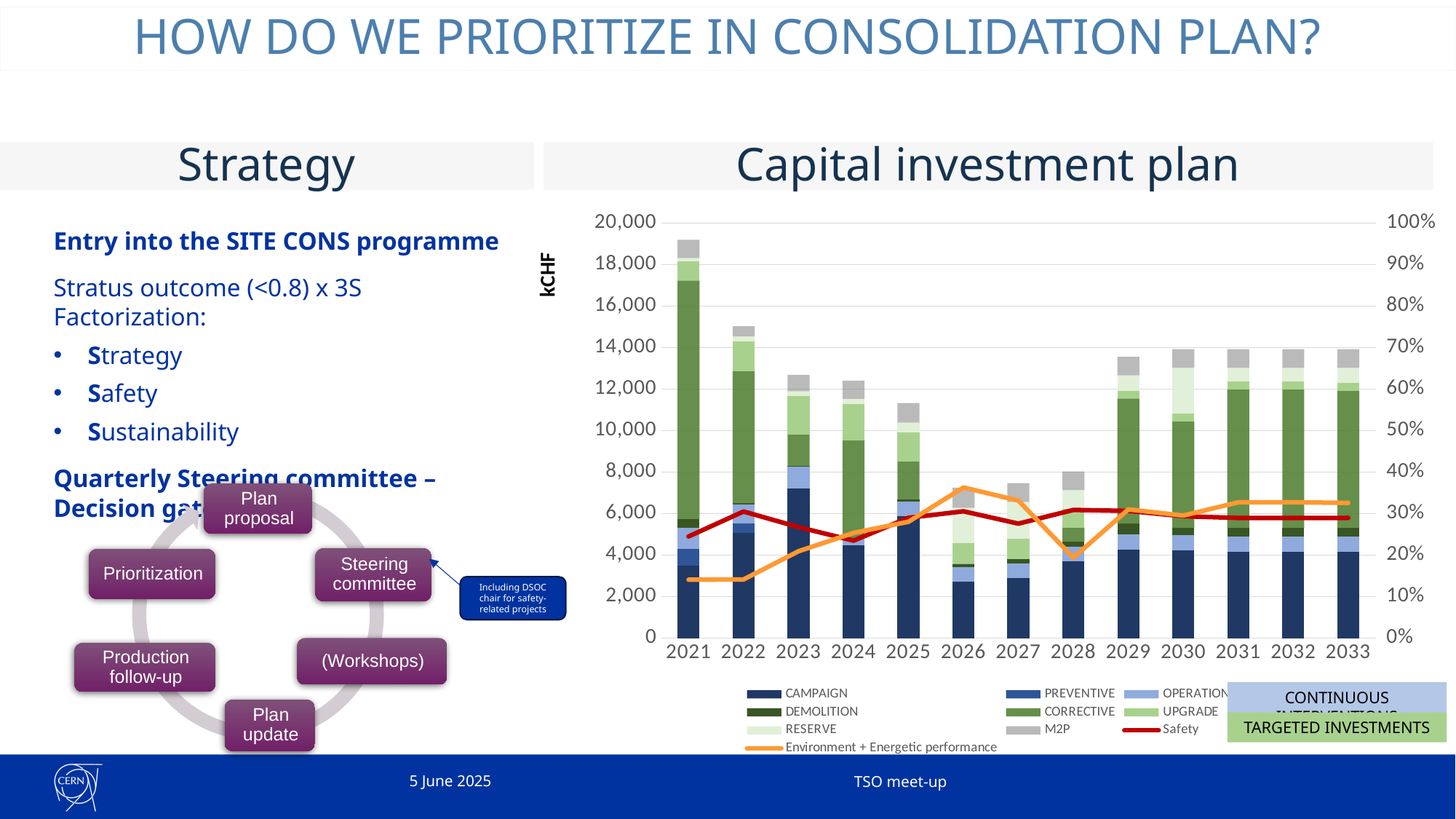
Is the total stacked bar for 2026 greater or less than 8,000 kCHF? less What unit is shown on the left vertical axis of the Capital investment plan chart? kCHF Which year has the larger total stacked bar, 2021 or 2022? 2021 How many series does the legend of the Capital investment plan chart list? 10 Is the total stacked bar for 2021 greater or less than 18,000 kCHF? greater Is the 'Environment + Energetic performance' line value for 2021 greater or less than 20%? less How many years are shown on the x axis of the Capital investment plan chart? 13 What kind of chart is shown under 'Capital investment plan'? Stacked bar chart with line series Do the total stacked bars rise or fall from 2021 to 2026? fall Which year has the larger total stacked bar, 2028 or 2029? 2029 Which year has the tallest stacked bar in the Capital investment plan chart? 2021